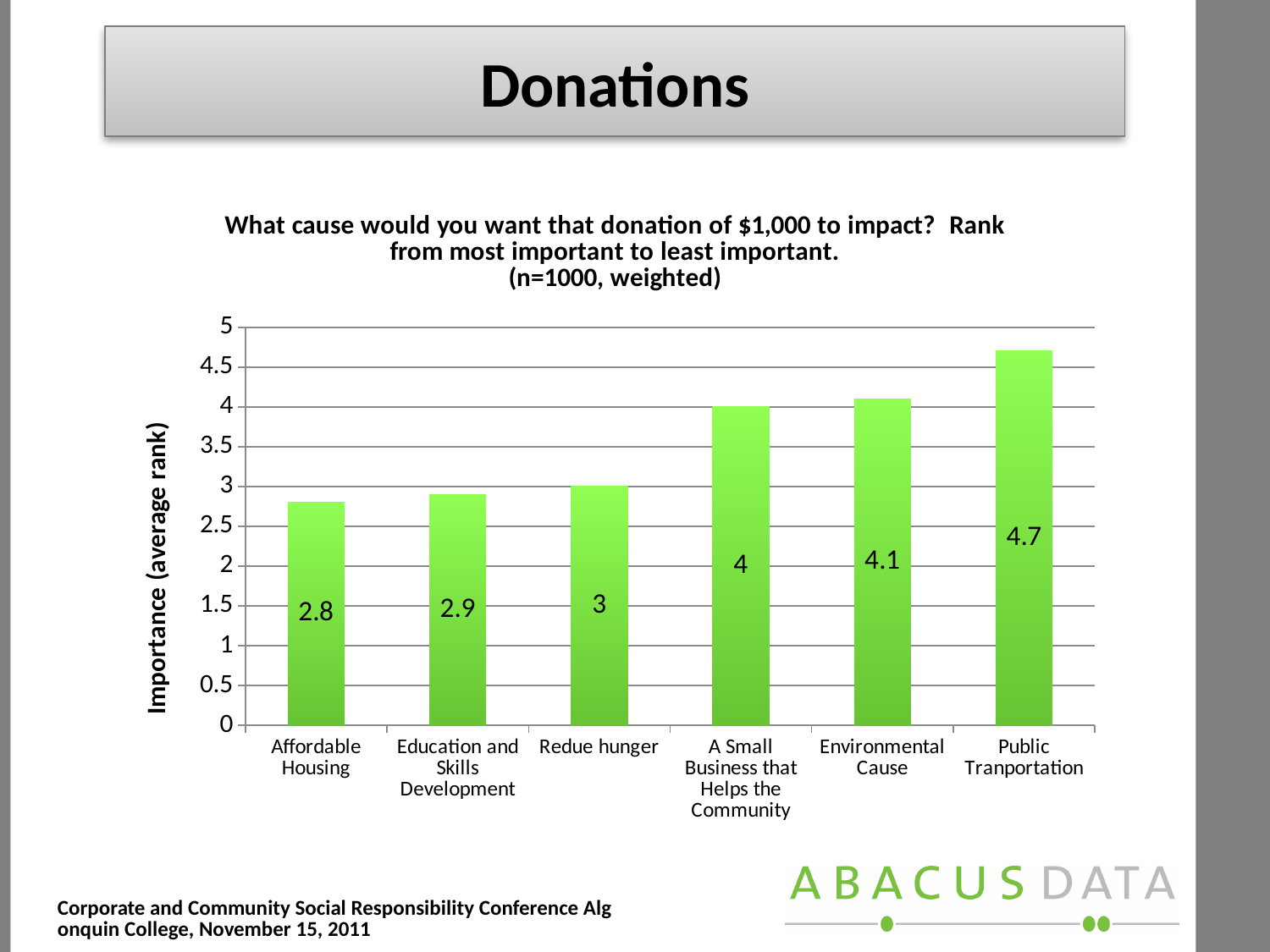
Which category has the highest average rank? Public Tranportation What kind of chart is shown on the slide? Bar chart Do the values rise or fall from left to right along the x axis? Rise What is the average rank value for Affordable Housing? 2.8 What is the label of the vertical axis? Importance (average rank) What is the average rank value for Environmental Cause? 4.1 What is the average rank value for Public Tranportation? 4.7 How many categories are shown on the chart? 6 What is the difference between the values for Public Tranportation and Affordable Housing? 1.9 Which has a higher value, Redue hunger or A Small Business that Helps the Community? A Small Business that Helps the Community What is the difference between the values for Environmental Cause and A Small Business that Helps the Community? 0.1 Which category has the lowest average rank? Affordable Housing